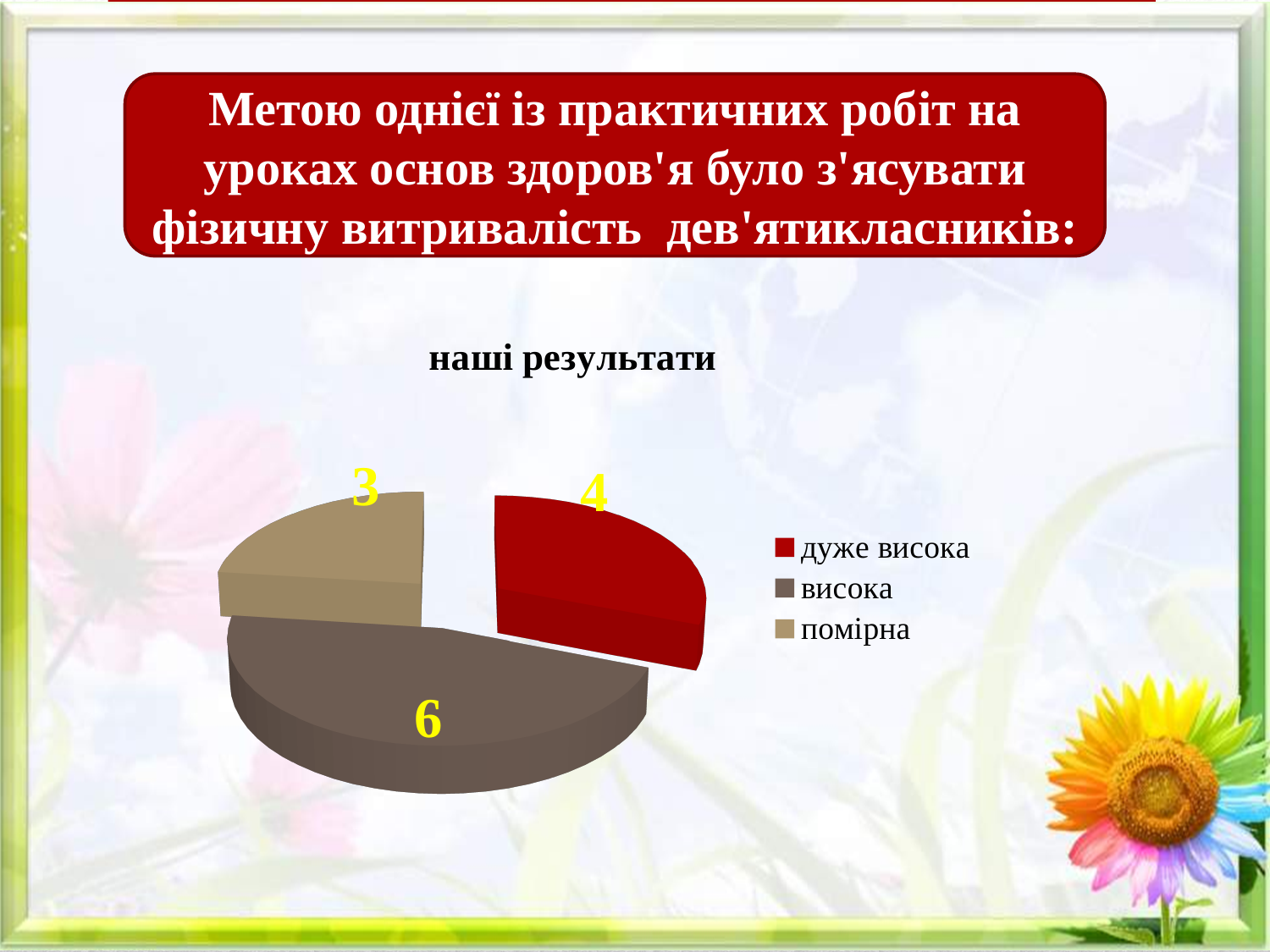
What is the value for "висока"? 6 What is the title of the chart? наші результати What kind of chart is shown on the slide? pie chart How many entries does the legend list? 3 What is the total of all slices in the pie chart? 13 Which category has the largest slice? висока What is the difference between the values for "висока" and "помірна"? 3 Which is larger, the value for "дуже висока" or the value for "помірна"? дуже висока How many slices does the pie chart have? 3 Which category has the smallest slice? помірна What is the value for "дуже висока"? 4 What is the value for "помірна"? 3